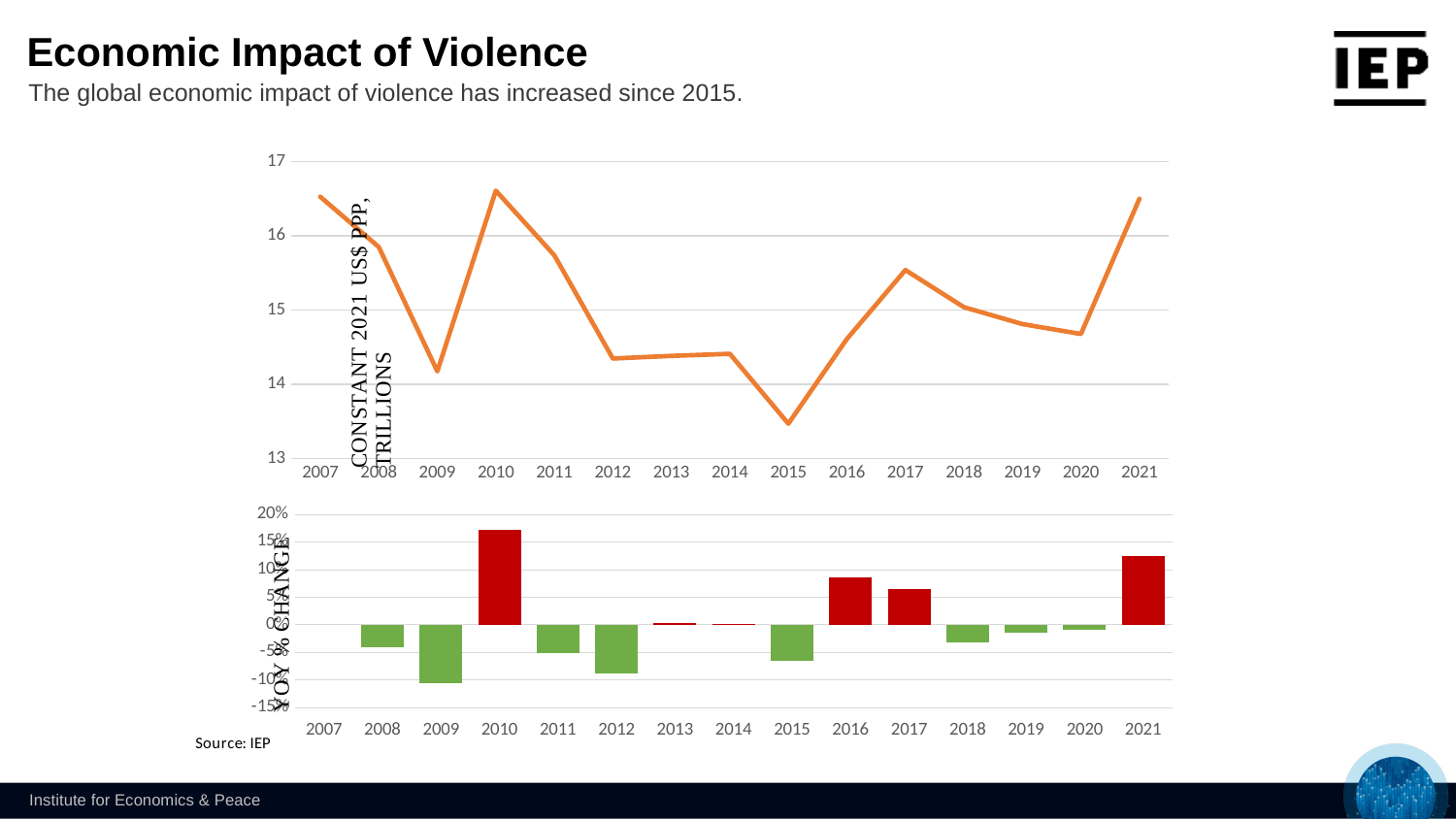
In the top chart, which is larger, the value for 2017 or the value for 2019? 2017 In the top chart, do the values rise or fall from 2015 to 2017? rise In the top chart, is the value for 2010 greater or less than 16? greater In the bottom chart (YoY % change), which year has the lowest value? 2009 How many years are plotted on the x axis of the top chart? 15 What kind of chart is the top chart on the slide? line chart What kind of chart is the bottom chart on the slide? bar chart In the bottom chart (YoY % change), which year has the highest value? 2010 In the bottom chart (YoY % change), is the value for 2021 greater or less than 10%? greater In the top chart, which year has the lowest value? 2015 What is the y-axis title of the top chart? CONSTANT 2021 US$ PPP, TRILLIONS In the top chart, is the value for 2015 greater or less than 14? less